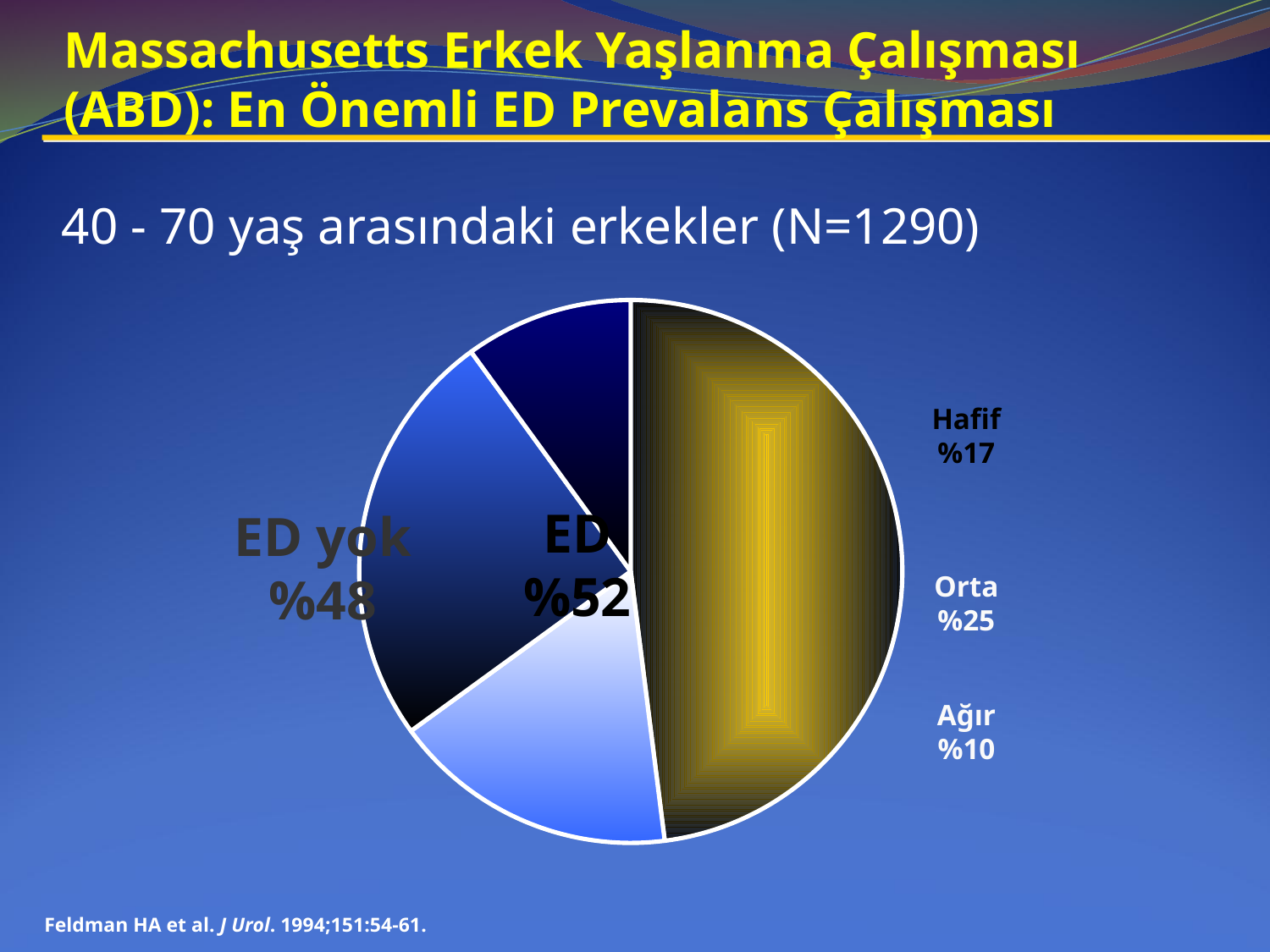
What type of chart is shown on the slide? Pie chart What do the Hafif, Orta and Ağır percentages add up to? %52 What percentage of men in the pie chart have no ED (ED yok)? %48 Which group is larger, ED or ED yok? ED What percentage of men in the pie chart have ED? %52 What percentage is labelled Hafif (mild) on the pie chart? %17 What is the difference in percentage points between the ED and ED yok groups? 4 How many men (N) were included in the study shown on the slide? 1290 What percentage is labelled Ağır (severe) on the pie chart? %10 Among the ED severity categories Hafif, Orta and Ağır, which has the lowest percentage? Ağır Among the ED severity categories Hafif, Orta and Ağır, which has the highest percentage? Orta What percentage is labelled Orta (moderate) on the pie chart? %25